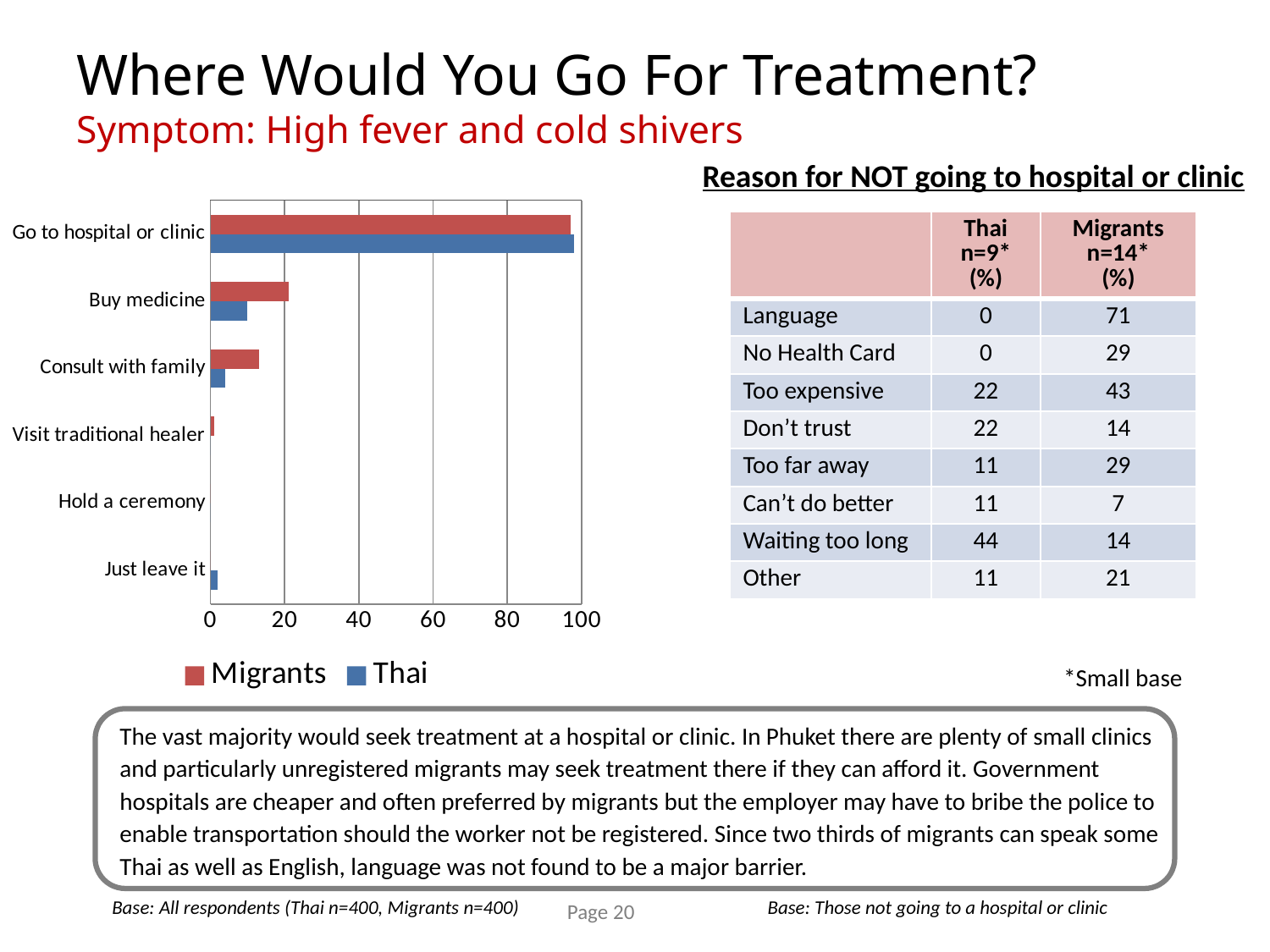
Is the Migrants value for 'Go to hospital or clinic' greater or less than 80? greater How many series does the chart legend list? 2 Is the Migrants value for 'Buy medicine' greater or less than 40? less How many treatment options (categories) are shown on the chart's vertical axis? 6 What kind of chart is shown on the slide? bar chart What colour are the bars for the Migrants series? red Is the Thai value for 'Buy medicine' greater or less than 20? less What are the two entries in the chart legend? Migrants and Thai For 'Consult with family', which series has the larger value, Migrants or Thai? Migrants For 'Buy medicine', which series has the larger value, Migrants or Thai? Migrants Which category has the highest value for Migrants? Go to hospital or clinic Which category has the highest value for Thai? Go to hospital or clinic